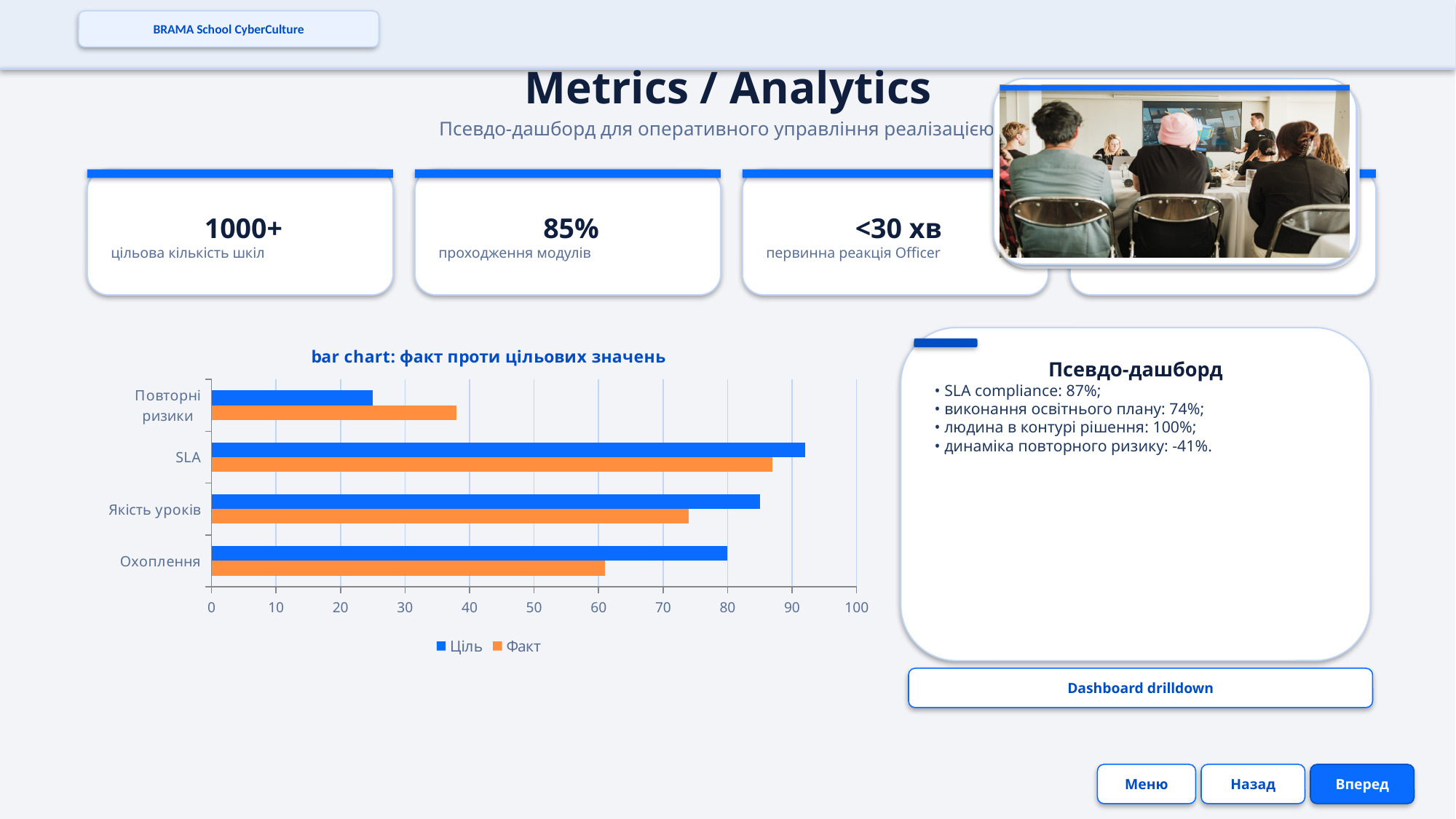
How many series does the chart legend list? 2 What kind of chart is shown on the slide? bar chart Which category has the lowest Ціль value? Повторні ризики Is the Ціль value for SLA greater or less than 90? greater Which category has the highest Факт value? SLA What are the two series names shown in the chart legend? Ціль and Факт For Охоплення, which is larger: Ціль or Факт? Ціль Which category has the lowest Факт value? Повторні ризики How many categories are plotted on the chart? 4 Which category has the highest Ціль value? SLA Is the Факт value for Охоплення greater or less than 70? less For Повторні ризики, which is larger: Ціль or Факт? Факт